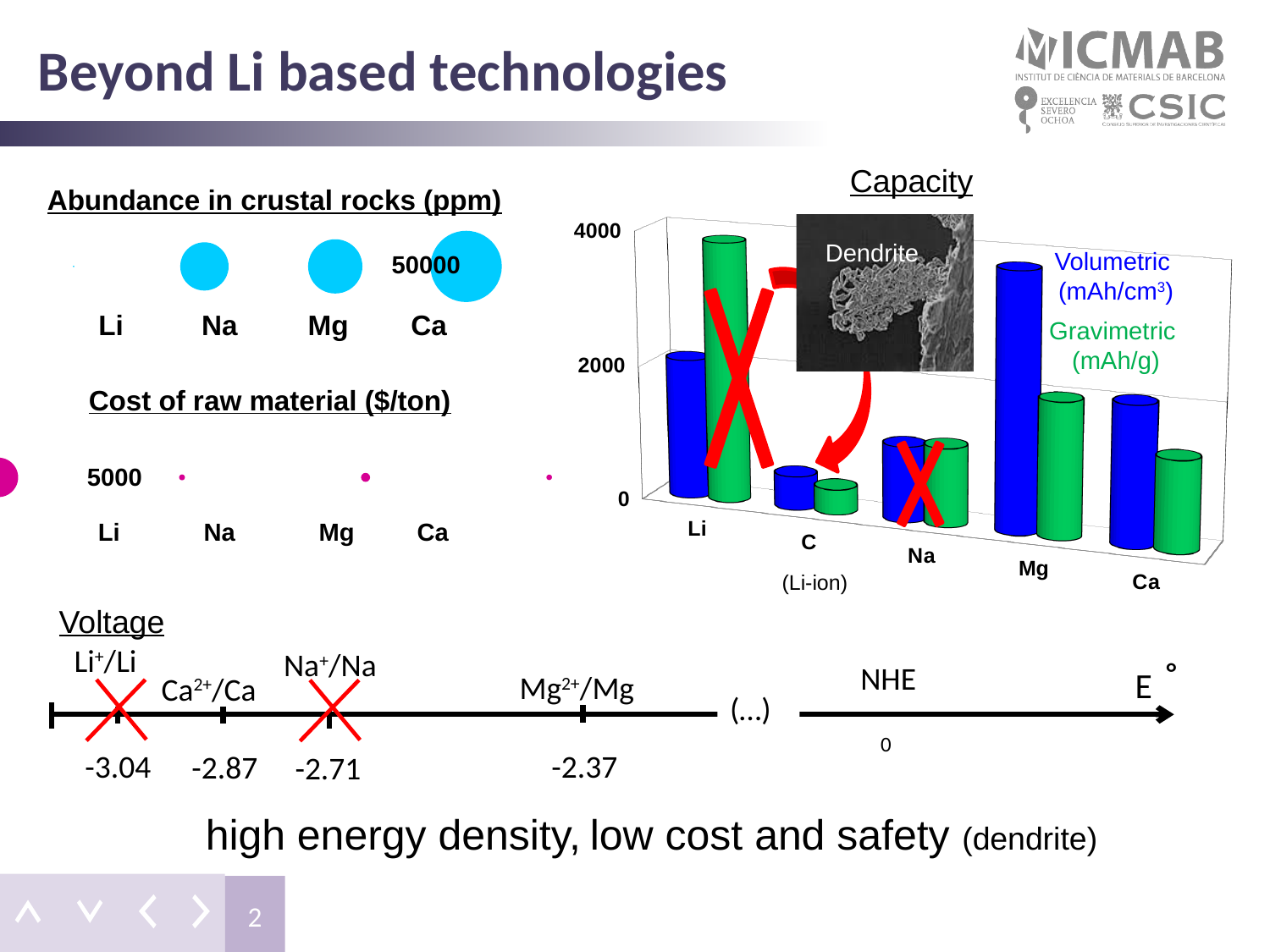
How many categories are shown on the x axis of the Capacity chart? 5 In the Capacity chart, is the Volumetric (mAh/cm³) value for Mg greater or less than 2000? greater In the Capacity chart, which is larger, the Gravimetric value for Li or the Gravimetric value for Ca? Li In the Capacity chart, is the Gravimetric (mAh/g) value for Li greater or less than 2000? greater In the Capacity chart, is the Volumetric (mAh/cm³) value for Na greater or less than 2000? less In the Capacity chart, which category has the highest Volumetric (mAh/cm³) value? Mg What kind of chart is the Capacity chart? bar chart In the Capacity chart, which is larger, the Volumetric value for Mg or the Volumetric value for Na? Mg In the Capacity chart, which category has the lowest Volumetric (mAh/cm³) value? C In the Capacity chart, which category has the highest Gravimetric (mAh/g) value? Li How many series does the Capacity chart show? 2